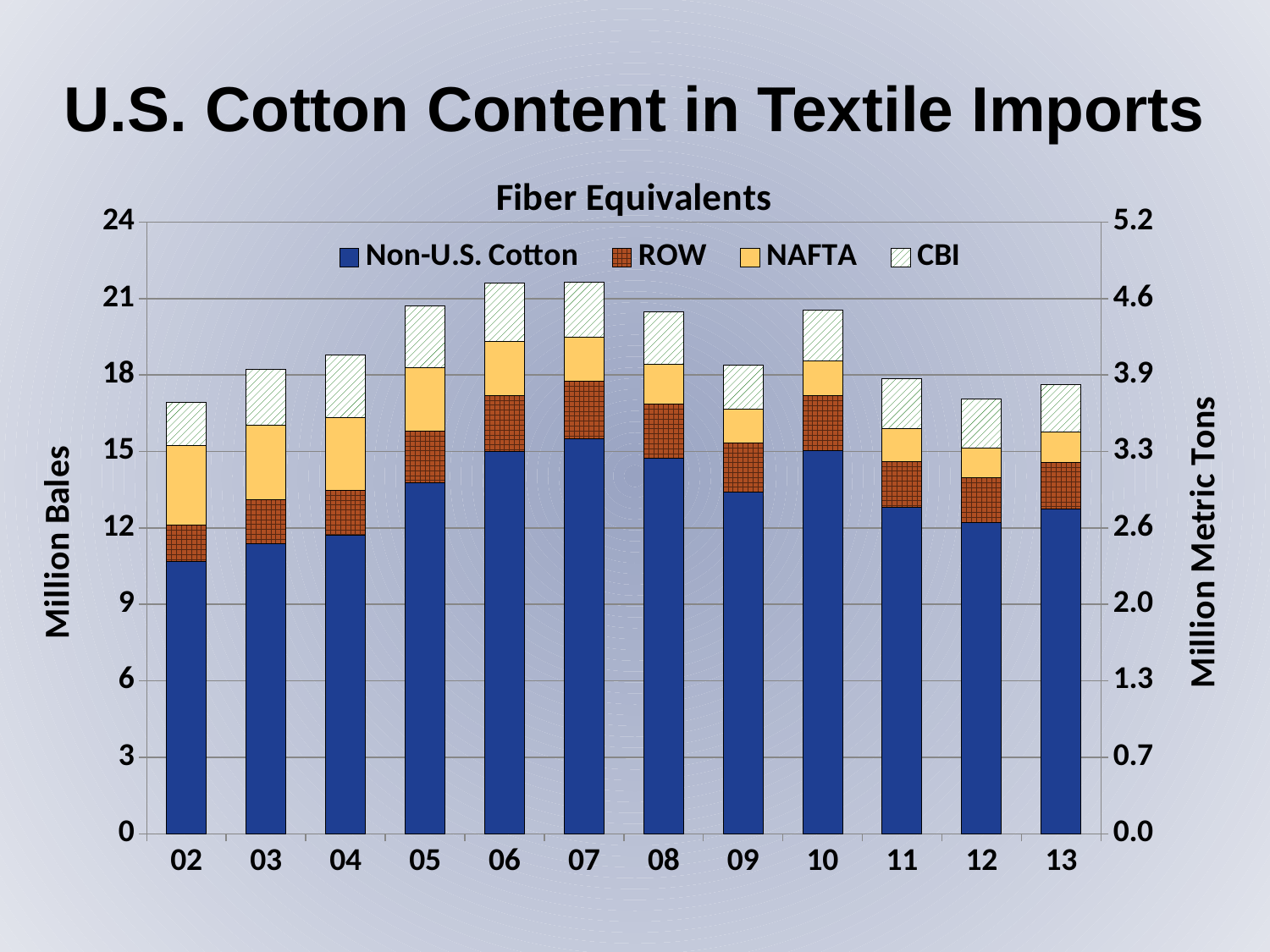
How many series does the chart's legend list? 4 Is the Non-U.S. Cotton value for 02 greater or less than 12 million bales? less How many years are shown on the x axis of the chart? 12 Is the total height of the bar for 02 greater or less than 18 million bales? less Which year has the larger Non-U.S. Cotton segment, 07 or 02? 07 Which series are listed in the chart's legend? Non-U.S. Cotton, ROW, NAFTA, CBI What is the label of the left vertical axis? Million Bales Is the total height of the bar for 06 greater or less than 21 million bales? greater Which year has the taller total bar, 05 or 03? 05 What kind of chart is shown on the slide? Stacked bar chart Do the total bar heights rise or fall from 02 to 07? rise